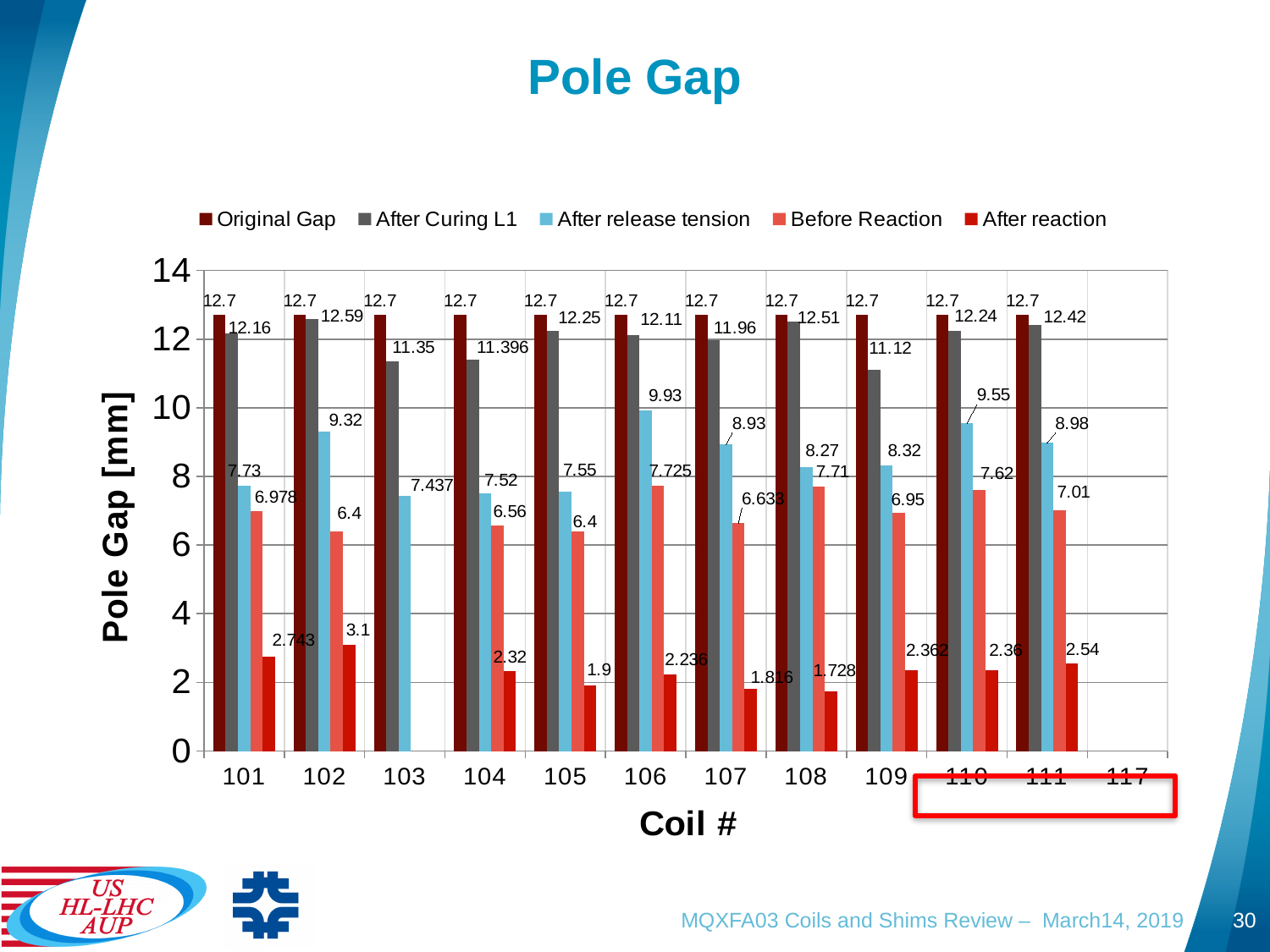
Which coil has the lowest After reaction value? 108 What is the After release tension value for coil 106? 9.93 How many coil numbers are shown on the x axis? 12 What is the difference between the Original Gap and the After Curing L1 value for coil 109? 1.58 How many series does the legend list? 5 Which coil has the highest After reaction value? 102 What is the title of the y axis? Pole Gap [mm] Which coil has the larger Before Reaction value, 108 or 110? 108 What is the After reaction value for coil 102? 3.1 What kind of chart is shown on the slide? bar chart Which coil has the highest After release tension value? 106 What is the After Curing L1 value for coil 103? 11.35